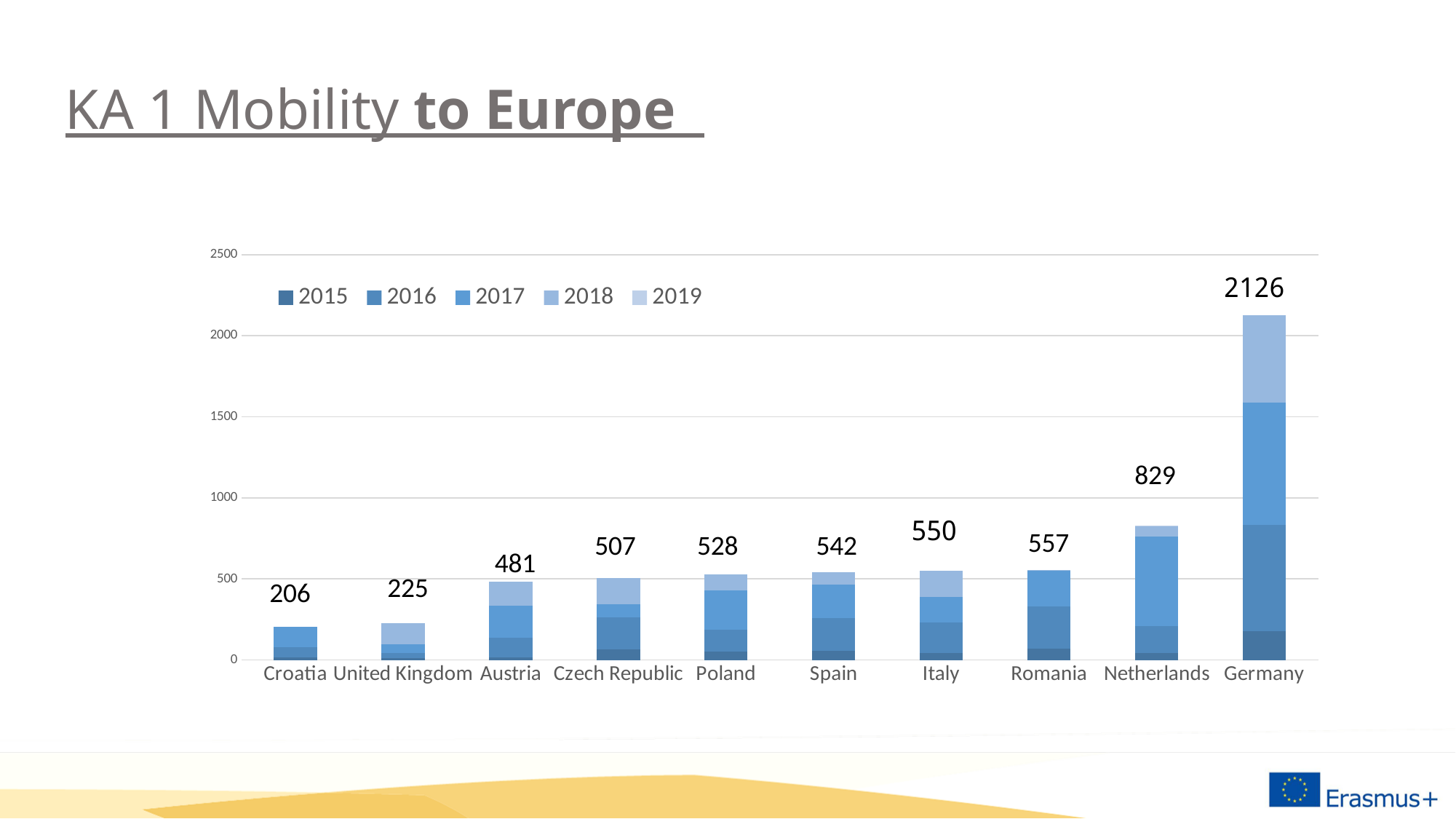
Which country has the highest total? Germany What is the total value shown for the Netherlands? 829 What is the total value shown for Croatia? 206 What is the difference between the totals for the United Kingdom and Croatia? 19 Which country has the lowest total? Croatia What kind of chart is shown? Stacked bar chart Do the totals rise or fall from left to right along the x axis? Rise What is the difference between the totals for Germany and the Netherlands? 1297 How many series does the legend list? 5 How many countries are shown on the x axis? 10 Which has a larger total, Romania or Italy? Romania What is the total value shown for Germany? 2126